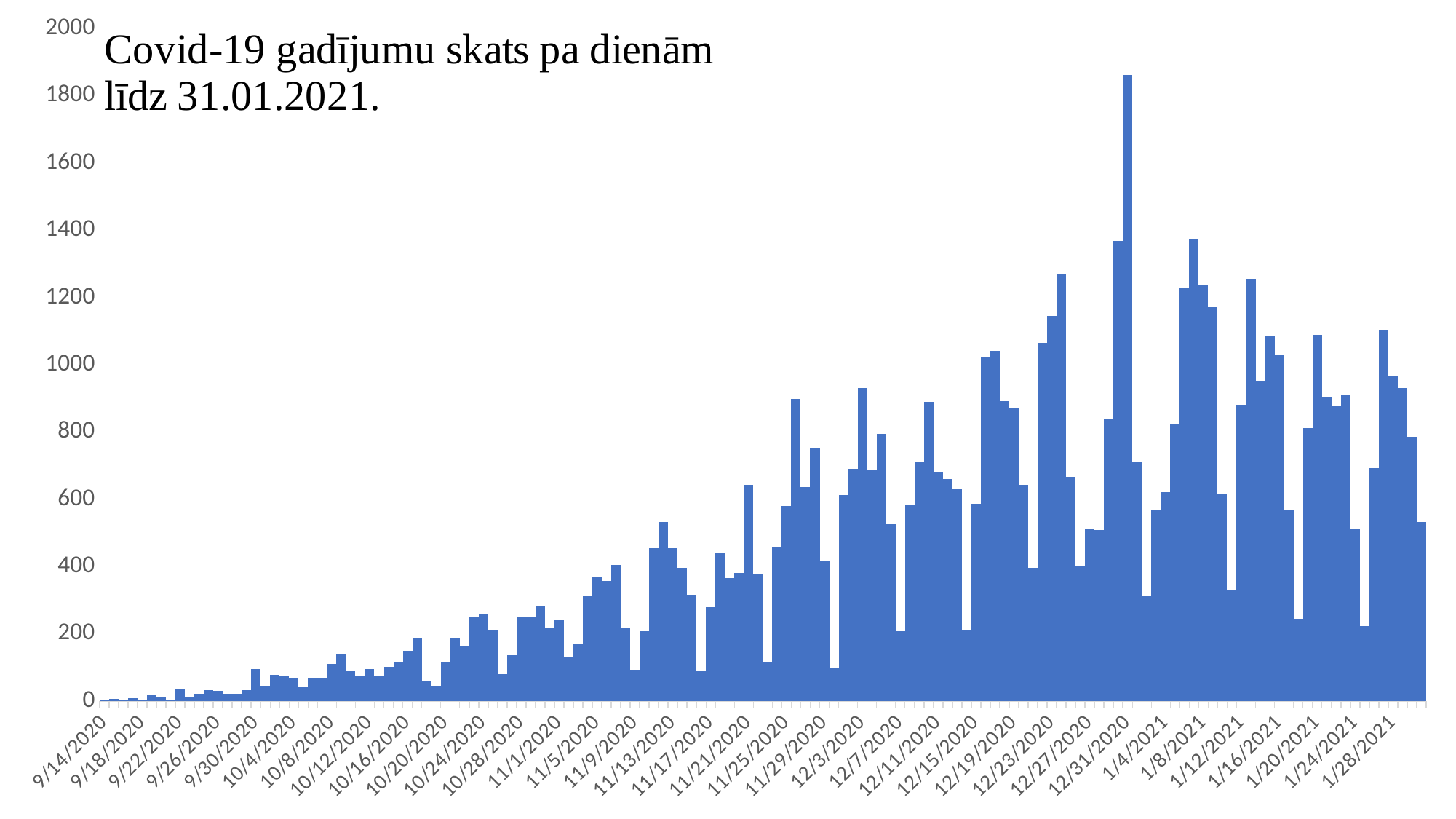
What is the highest value shown on the vertical axis? 2000 Which is larger, the value for 12/31/2020 or the value for 9/14/2020? 12/31/2020 Is the value for 10/4/2020 greater or less than 200? less What is the title of the chart? Covid-19 gadījumu skats pa dienām līdz 31.01.2021. Which is larger, the value for 1/8/2021 or the value for 10/8/2020? 1/8/2021 Overall, do the daily case values rise or fall from September 2020 to January 2021? rise Is the value for 9/14/2020 greater or less than 200? less Which date has the tallest bar in the chart? 12/31/2020 Is the value for 11/1/2020 greater or less than 400? less What kind of chart is shown on the slide? bar chart